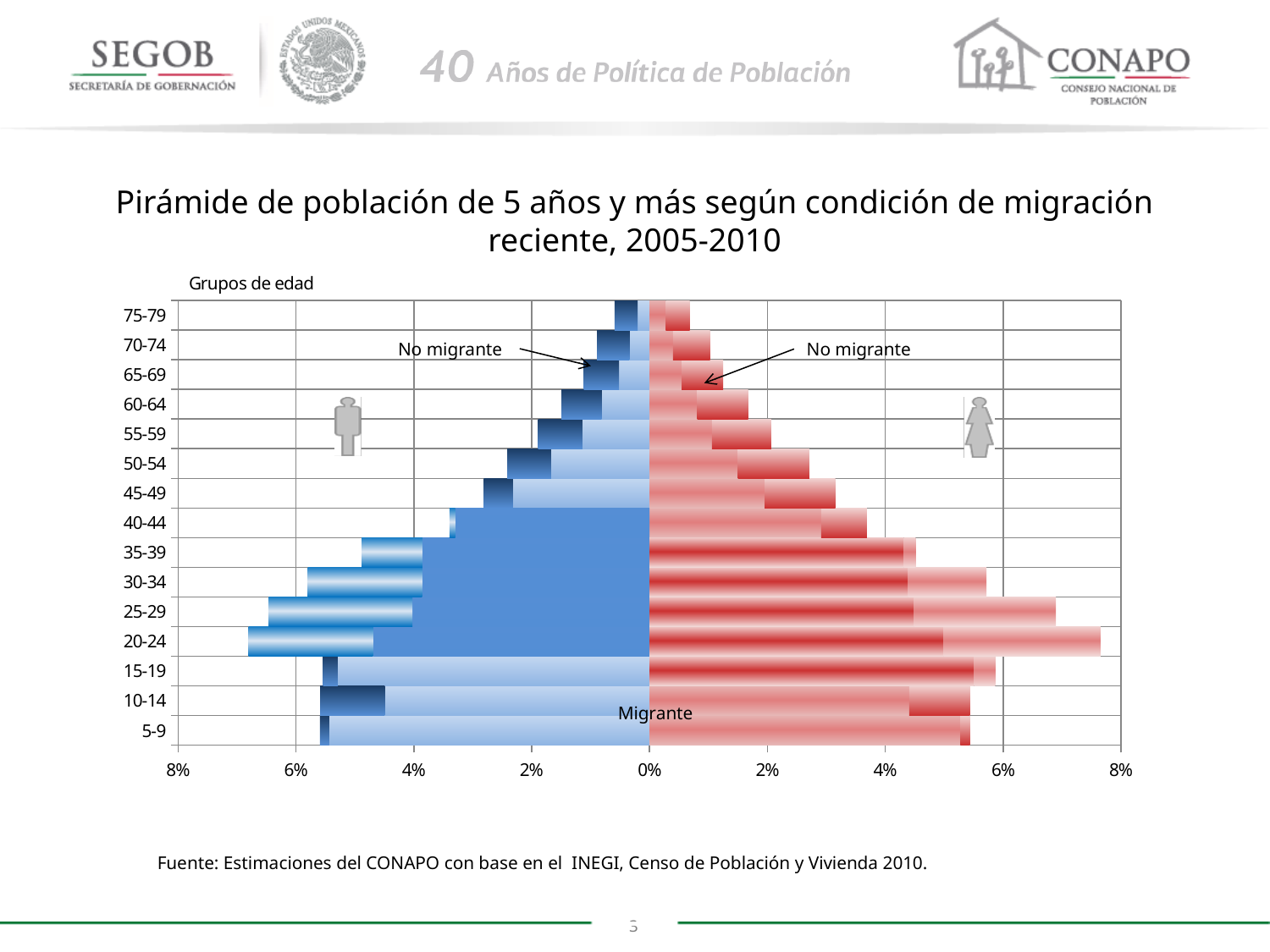
What is the title of the chart? Pirámide de población de 5 años y más según condición de migración reciente, 2005-2010 How many age groups are shown on the vertical axis of the pyramid? 15 Is the total value for the 20-24 age group on the right (female) side greater or less than 6%? greater What are the two migration conditions labelled on the chart? Migrante and No migrante Is the total value for the 75-79 age group on the left (male) side greater or less than 2%? less Which age group has the shortest bar on the right (female) side of the pyramid? 75-79 On the right (female) side, which bar is longer: 20-24 or 40-44? 20-24 Moving from the 20-24 age group up to the 75-79 age group, do the bar lengths rise or fall? fall What kind of chart is shown on the slide? bar chart (population pyramid) Which age group has the longest bar on the left (male) side of the pyramid? 20-24 Is the total value for the 20-24 age group on the left (male) side greater or less than 6%? greater Which age group has the longest bar on the right (female) side of the pyramid? 20-24